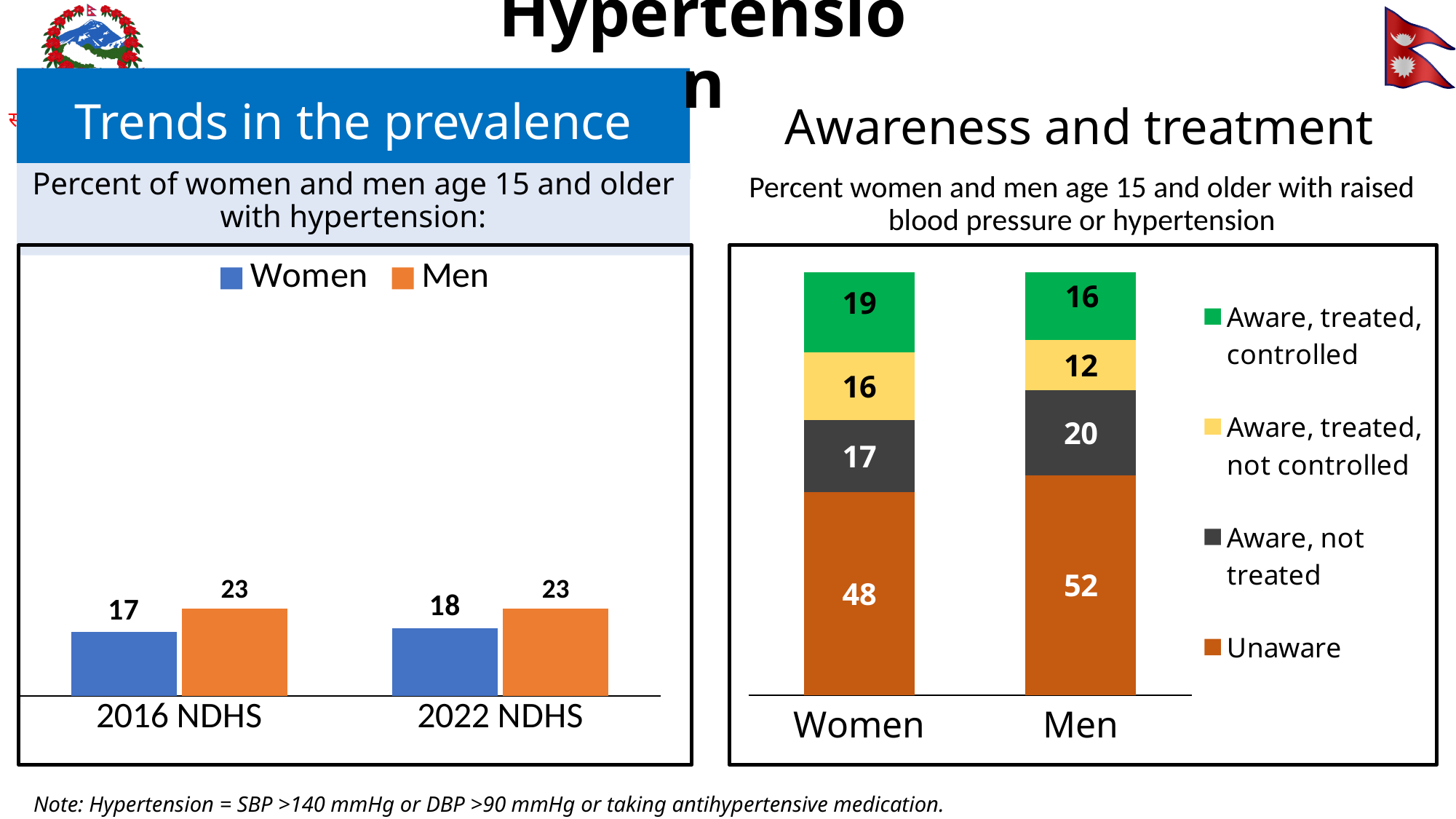
In the 'Awareness and treatment' chart, what is the 'Aware, treated, controlled' value for Women? 19 In the 'Trends in the prevalence' chart, what is the difference between Men and Women in 2016 NDHS? 6 In the 'Trends in the prevalence' chart, what is the value for Women in 2016 NDHS? 17 In the 'Trends in the prevalence' chart, how many series does the legend list? 2 In the 'Awareness and treatment' chart, how many series does the legend list? 4 In the 'Awareness and treatment' chart, which segment is the largest in the Women bar? Unaware In the 'Awareness and treatment' chart, what is the total of the Women bar? 100 In the 'Awareness and treatment' chart, what is the Unaware value for Men? 52 In the 'Awareness and treatment' chart, which is larger, the 'Aware, not treated' value for Women or for Men? Men In the 'Trends in the prevalence' chart, what is the value for Men in 2022 NDHS? 23 In the 'Trends in the prevalence' chart, what kind of chart is shown? bar chart In the 'Trends in the prevalence' chart, does the value for Women rise or fall from 2016 NDHS to 2022 NDHS? rise